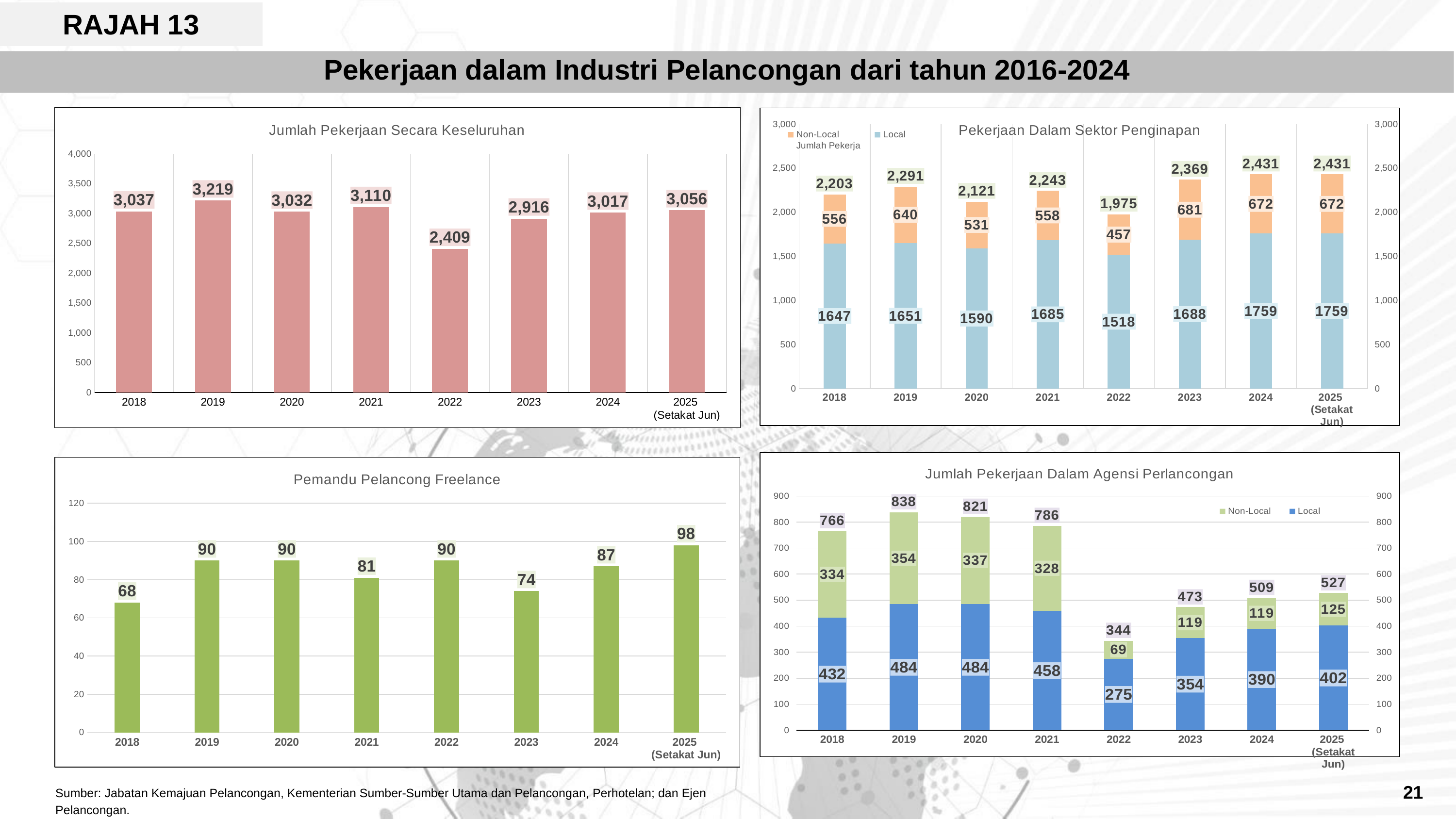
In the 'Jumlah Pekerjaan Dalam Agensi Perlancongan' chart, how many series does the legend list? 2 In the 'Jumlah Pekerjaan Secara Keseluruhan' chart, which year has the highest value? 2019 In the 'Pemandu Pelancong Freelance' chart, what is the value for 2021? 81 In the 'Pekerjaan Dalam Sektor Penginapan' chart, what is the total of the stacked bar for 2022? 1,975 In the 'Jumlah Pekerjaan Dalam Agensi Perlancongan' chart, is the Non-Local value for 2022 larger or smaller than the Non-Local value for 2023? smaller In the 'Jumlah Pekerjaan Secara Keseluruhan' chart, what is the difference between the 2019 value and the 2022 value? 810 In the 'Jumlah Pekerjaan Dalam Agensi Perlancongan' chart, what is the Local value for 2024? 390 In the 'Pemandu Pelancong Freelance' chart, how many years are shown on the x axis? 8 In the 'Jumlah Pekerjaan Secara Keseluruhan' chart, what is the value for 2022? 2,409 In the 'Pemandu Pelancong Freelance' chart, which year has the lowest value? 2018 In the 'Pekerjaan Dalam Sektor Penginapan' chart, what is the Non-Local value for 2023? 681 In the 'Pekerjaan Dalam Sektor Penginapan' chart, which year has the lowest Local value? 2022